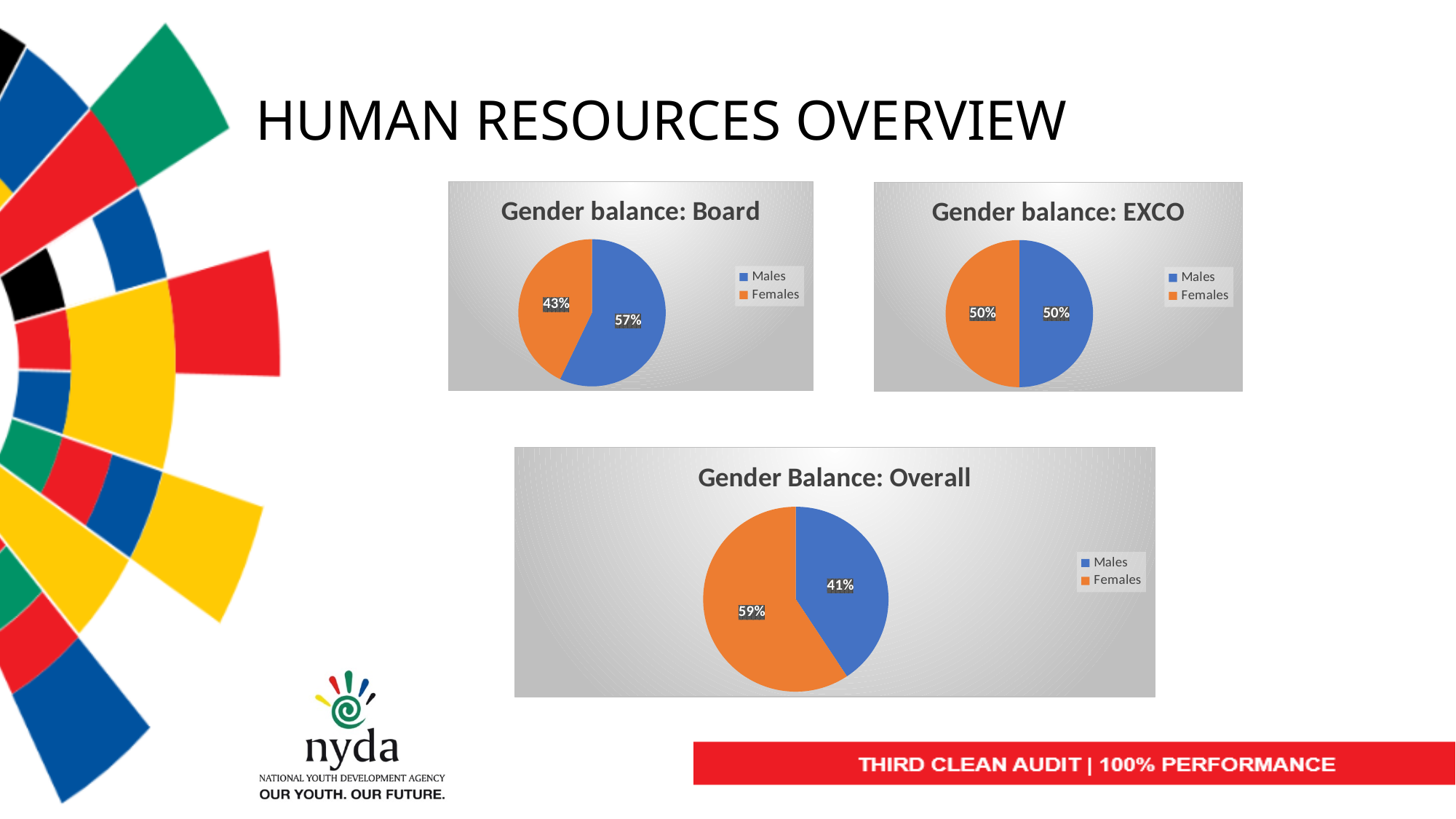
In the 'Gender Balance: Overall' chart, what percentage is shown for Males? 41% In the 'Gender balance: Board' chart, which group has the larger share? Males In the 'Gender balance: EXCO' chart, what percentage is shown for Males? 50% In the 'Gender balance: Board' chart, what percentage is shown for Females? 43% What type of chart is 'Gender balance: EXCO'? Pie chart In the 'Gender Balance: Overall' chart, what percentage is shown for Females? 59% In the 'Gender Balance: Overall' chart, which group has the smaller share? Males In the 'Gender balance: Board' chart, what percentage is shown for Males? 57% In the 'Gender Balance: Overall' chart, what is the difference in percentage points between Females and Males? 18 In the 'Gender balance: Board' chart, what is the difference in percentage points between Males and Females? 14 In the 'Gender balance: Board' chart, which colour represents Females? Orange How many categories does the legend of the 'Gender Balance: Overall' chart list? 2